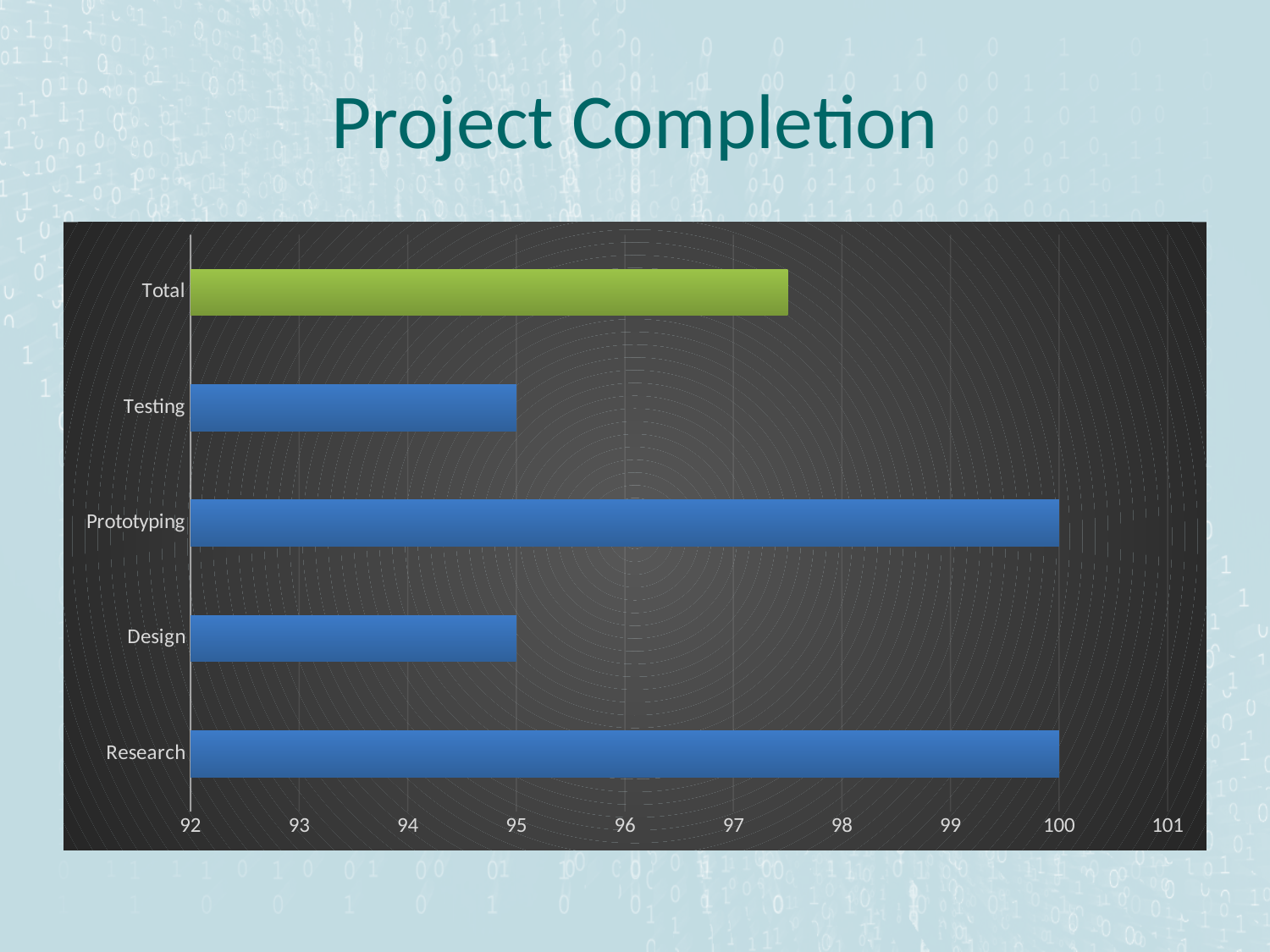
Which is larger, the value for Research or the value for Design? Research How many categories are plotted in the chart? 5 Is the value for Total greater or less than 97? greater Is the value for Total greater or less than 98? less What is the value for Design? 95 What is the title of the chart? Project Completion What type of chart is shown on the slide? bar chart Which category's bar is shown in a different colour (green) from the others? Total What is the difference between the values for Prototyping and Testing? 5 What is the value for Testing? 95 What is the value for Research? 100 What is the value for Prototyping? 100